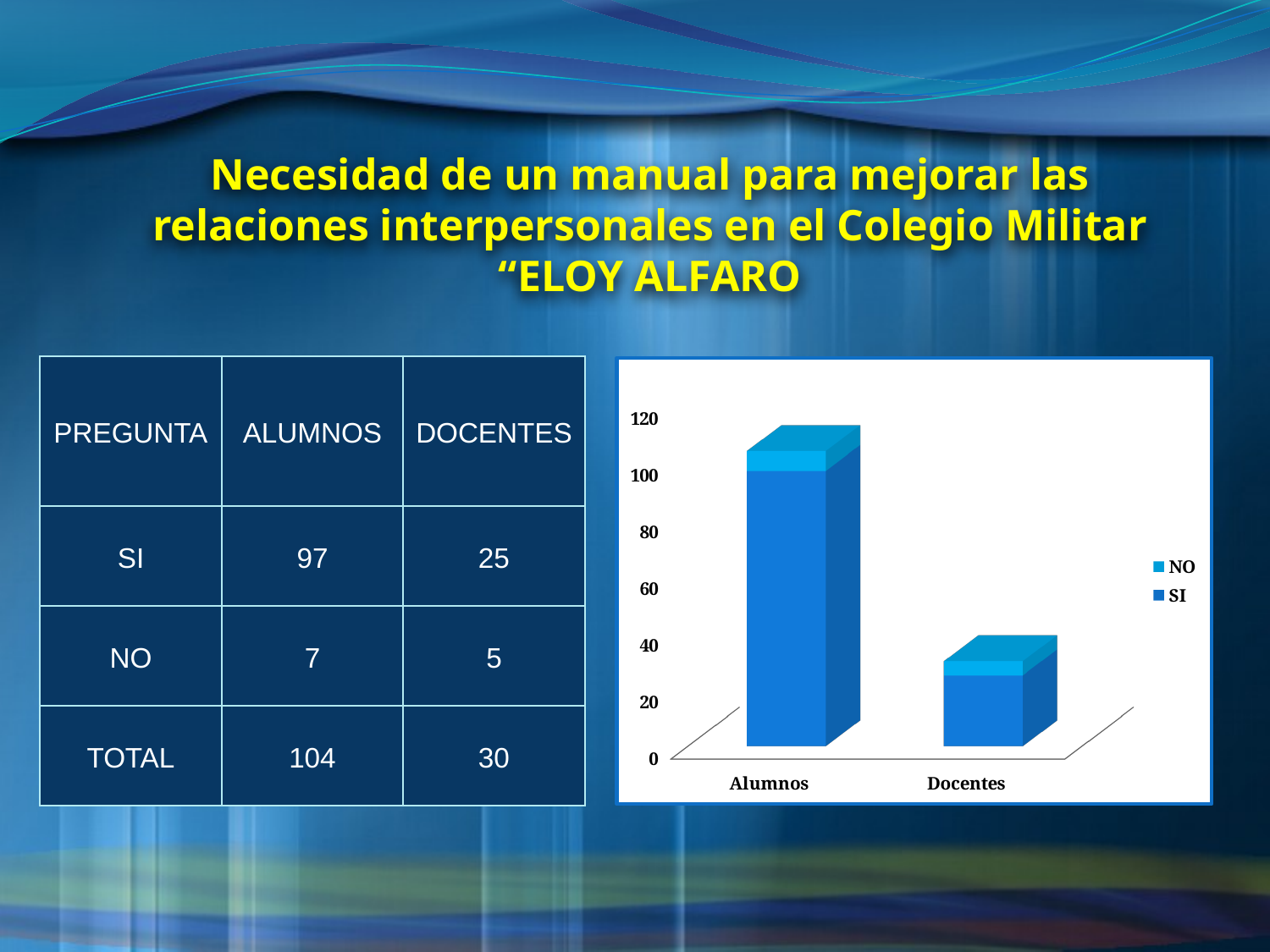
Using the values in the table, what is the difference between the SI values for Alumnos and Docentes? 72 What are the two series named in the chart legend? NO and SI Which category has the taller stacked bar, Alumnos or Docentes? Alumnos According to the table on the slide, what is the SI value for Alumnos plotted in the chart? 97 Which category has the lowest stacked bar in the chart? Docentes According to the table on the slide, what is the NO value for Docentes plotted in the chart? 5 Is the total height of the Docentes bar greater or less than 40? less What kind of chart is shown on the slide? bar chart Is the total height of the Alumnos bar greater or less than 100? greater How many series does the chart legend list? 2 How many categories are shown on the x axis of the chart? 2 Using the values in the table, what is the total of the stacked bar for Docentes? 30